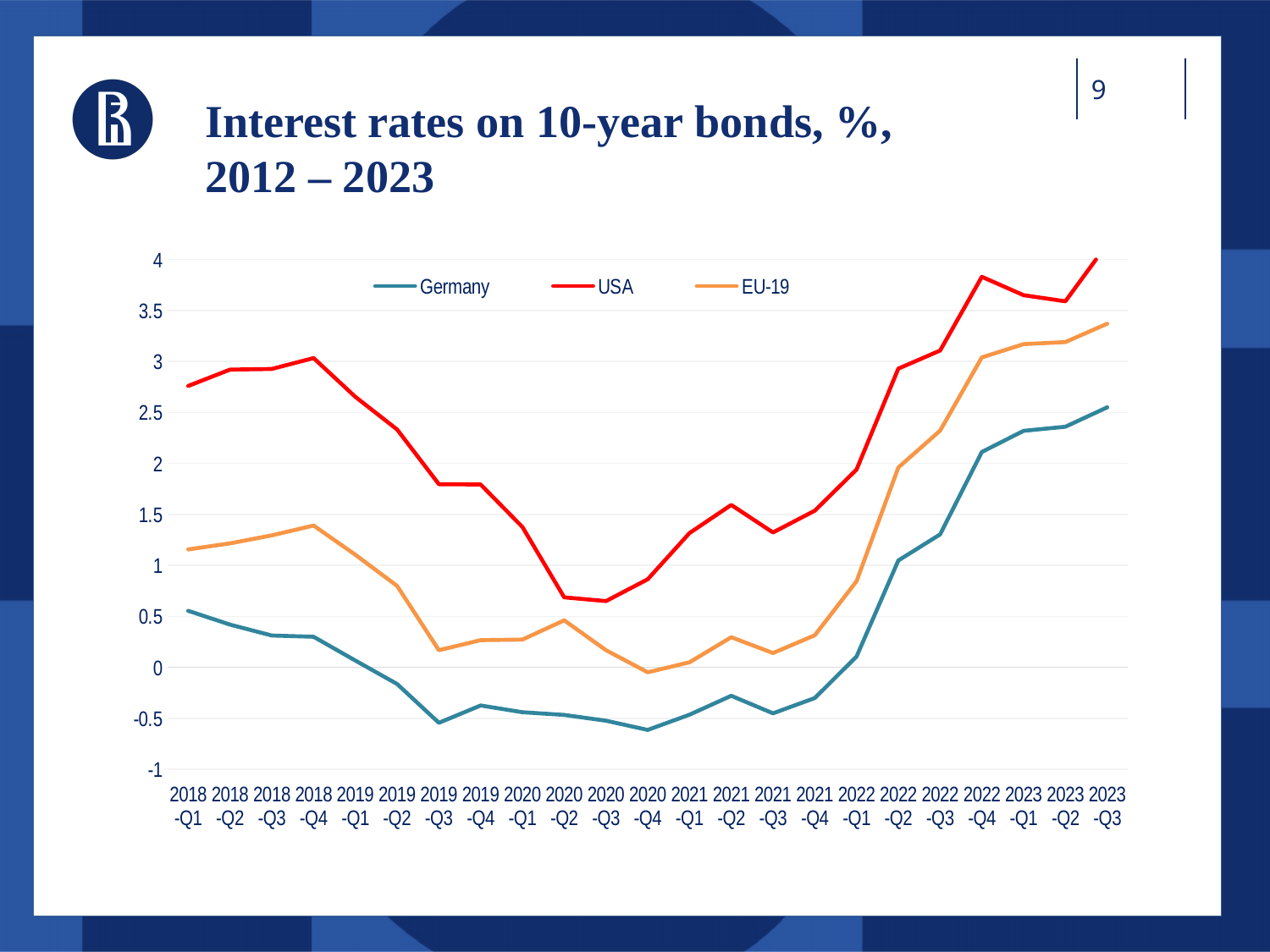
How many quarters are shown along the x axis? 23 What is the title of the chart? Interest rates on 10-year bonds, %, 2012 – 2023 Which series has the highest value at 2023-Q3? USA In which quarter does the Germany series reach its lowest value? 2020-Q4 Is the value for USA at 2018-Q1 greater or less than 2.5? greater Is the value for Germany at 2020-Q4 greater or less than -0.5? less Which is larger at 2020-Q1, the USA value or the Germany value? USA Is the value for EU-19 at 2023-Q3 greater or less than 3? greater Do the Germany values rise or fall from 2022-Q1 to 2023-Q3? rise Which series has the lowest value at 2020-Q4? Germany What kind of chart is shown on the slide? Line chart How many series does the legend list? 3